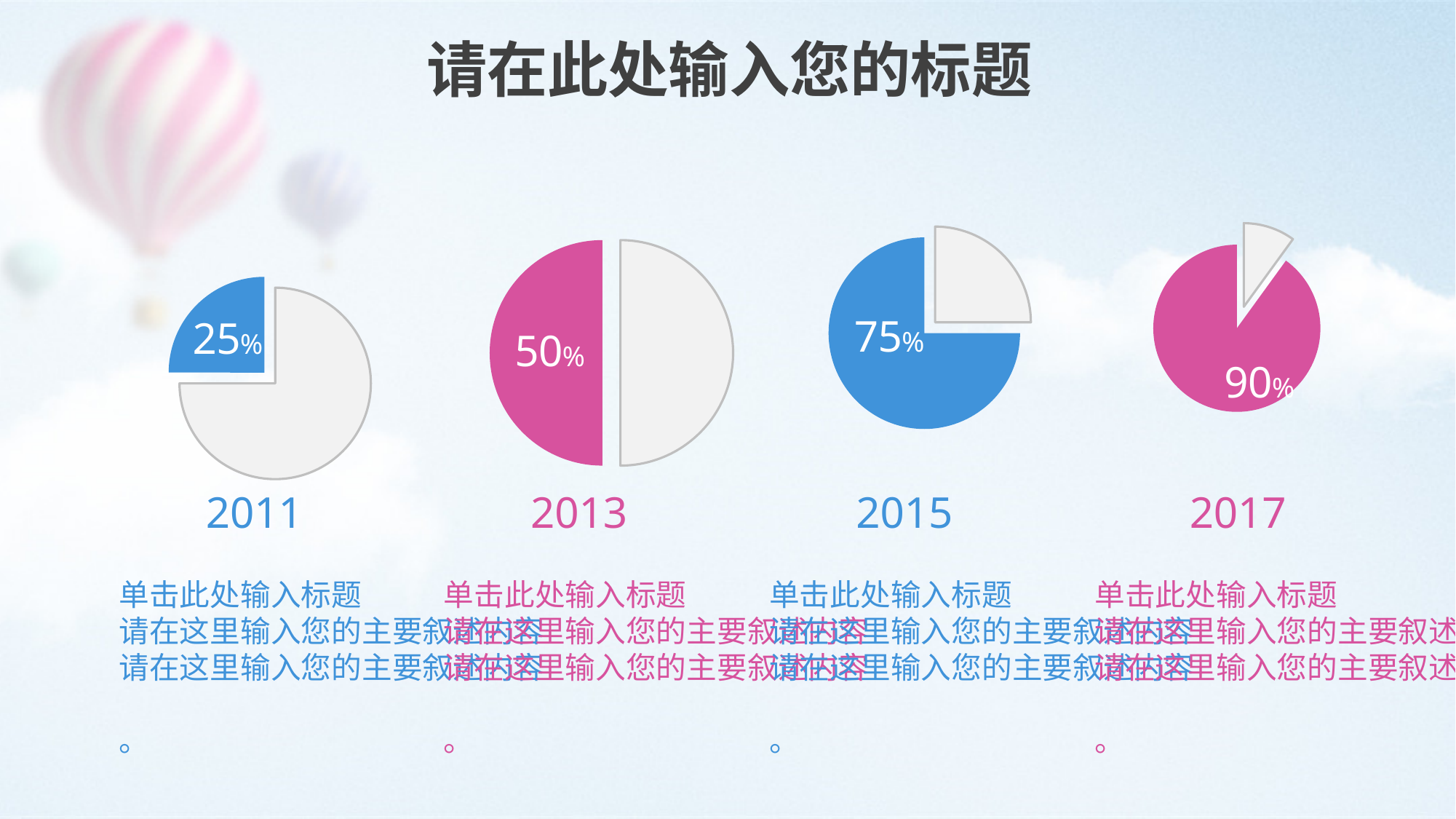
What percentage is shown on the pie chart labelled 2013? 50% What percentage is shown on the pie chart labelled 2017? 90% Which year's pie chart shows the lowest percentage? 2011 How many pie charts are on the slide? 4 Which is larger, the percentage shown for 2013 or the percentage shown for 2015? 2015 What colour is the highlighted slice in the pie chart labelled 2015? Blue Which year's pie chart shows the highest percentage? 2017 What percentage is shown on the pie chart labelled 2015? 75% Do the percentages rise or fall from 2011 to 2017 across the pie charts? Rise What percentage is shown on the pie chart labelled 2011? 25% What kind of chart is used for each of the four years on the slide? Pie chart What is the difference between the percentage shown for 2017 and the percentage shown for 2011? 65%